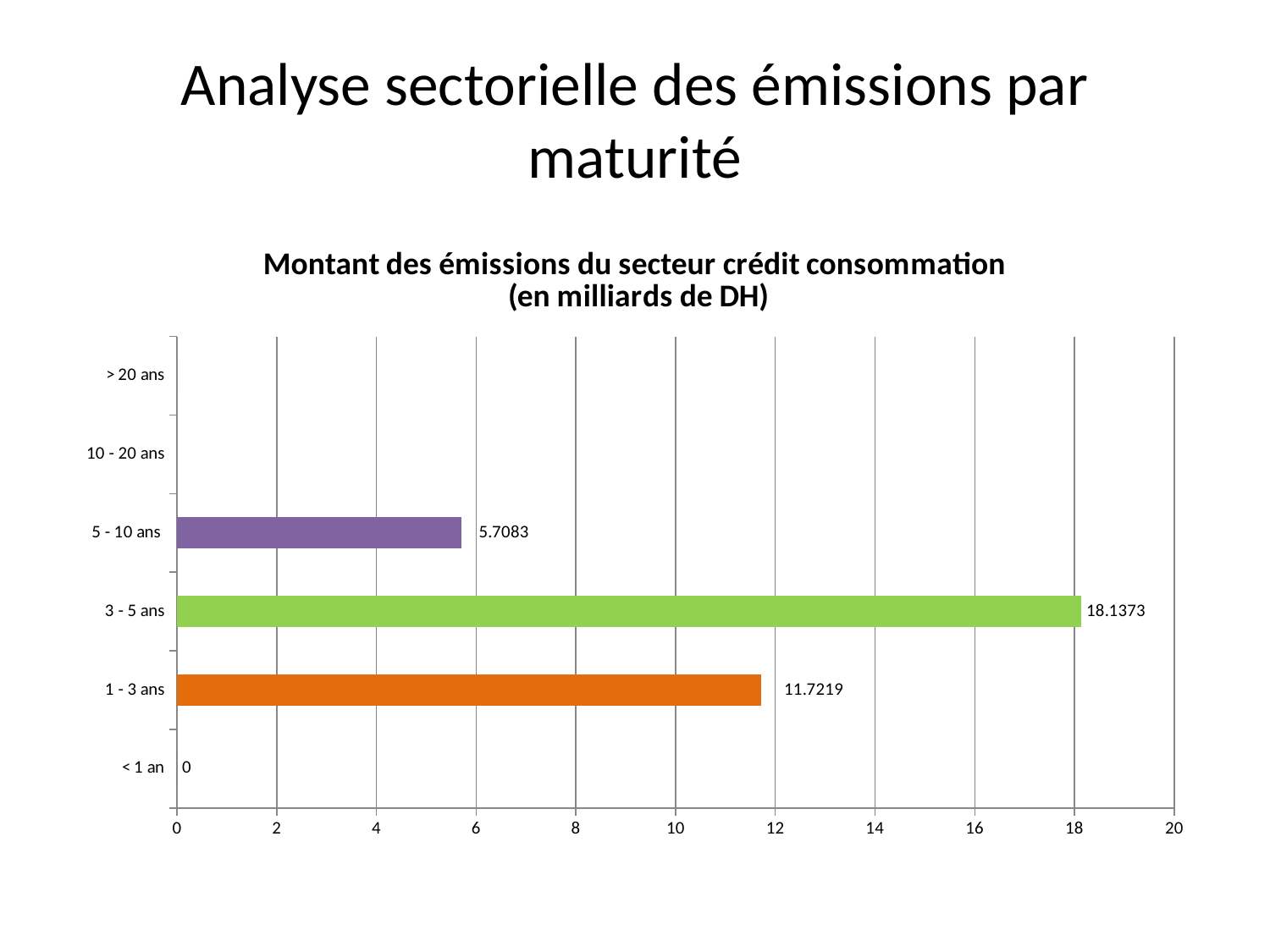
What is the value for the < 1 an category? 0 What is the value for the 1 - 3 ans category? 11.7219 Is the value for 3 - 5 ans greater or less than 16? greater What is the difference between the values for 3 - 5 ans and 1 - 3 ans? 6.4154 What is the title of the chart? Montant des émissions du secteur crédit consommation (en milliards de DH) What is the difference between the values for 1 - 3 ans and 5 - 10 ans? 6.0136 What is the value for the 5 - 10 ans category? 5.7083 How many maturity categories are shown on the y axis? 6 Which maturity category has the highest value? 3 - 5 ans Which is larger, the value for 1 - 3 ans or the value for 5 - 10 ans? 1 - 3 ans What kind of chart is shown on the slide? Bar chart What is the value for the 3 - 5 ans category? 18.1373